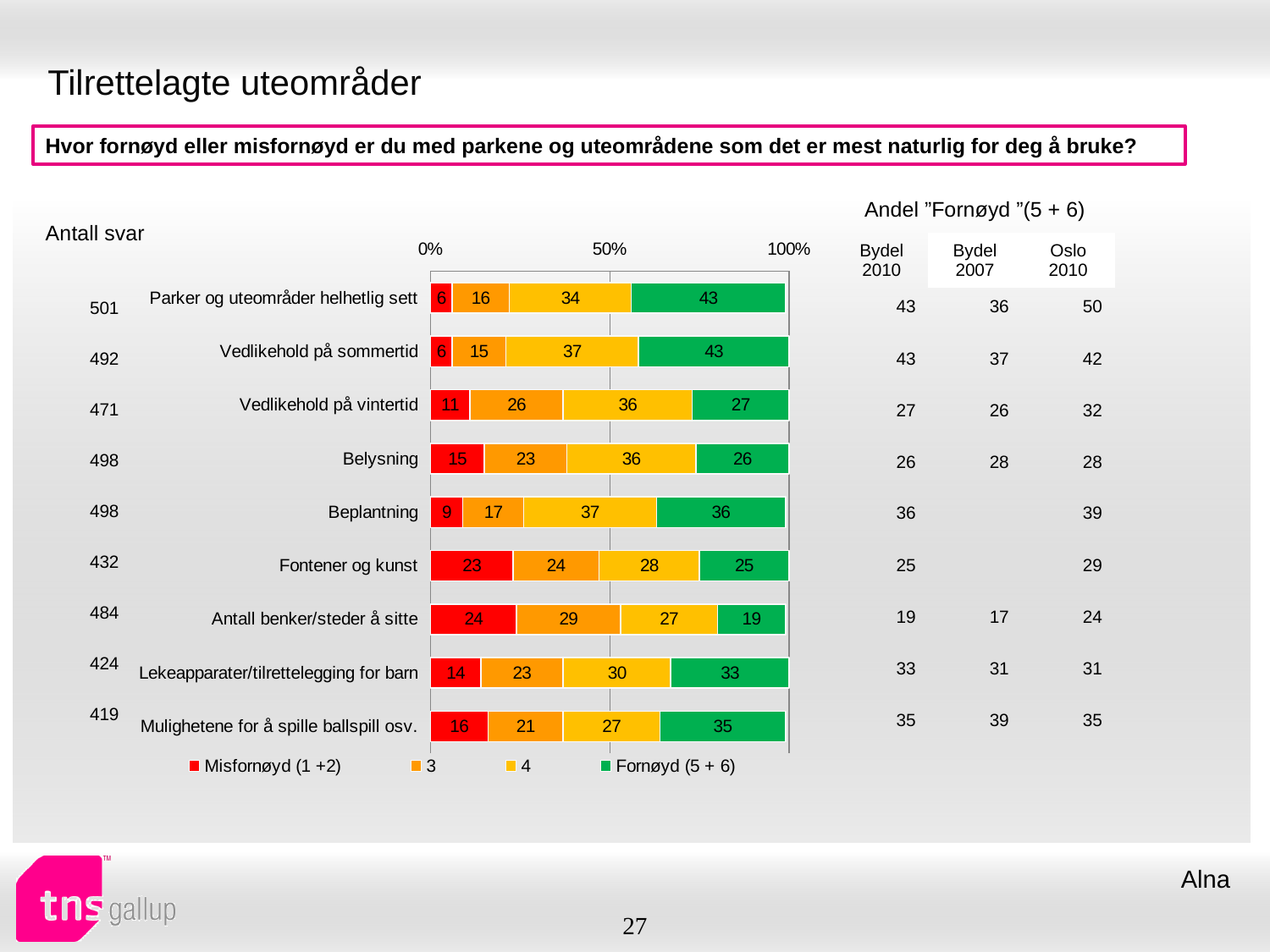
Which has a larger Fornøyd (5 + 6) value, Beplantning or Fontener og kunst? Beplantning How many categories are plotted in the chart? 9 Which colour represents the Fornøyd (5 + 6) series in the chart? Green What kind of chart is shown on the slide? Stacked bar chart How many series does the chart legend list? 4 What is the total of the stacked bar for Belysning? 100 Which category has the lowest Fornøyd (5 + 6) value? Antall benker/steder å sitte Which category has the highest Misfornøyd (1 +2) value? Antall benker/steder å sitte What is the value of the Fornøyd (5 + 6) segment for Parker og uteområder helhetlig sett? 43 What is the value of the '4' segment for Vedlikehold på sommertid? 37 What is the value of the Misfornøyd (1 +2) segment for Fontener og kunst? 23 What is the difference between the Fornøyd (5 + 6) values for Parker og uteområder helhetlig sett and Belysning? 17